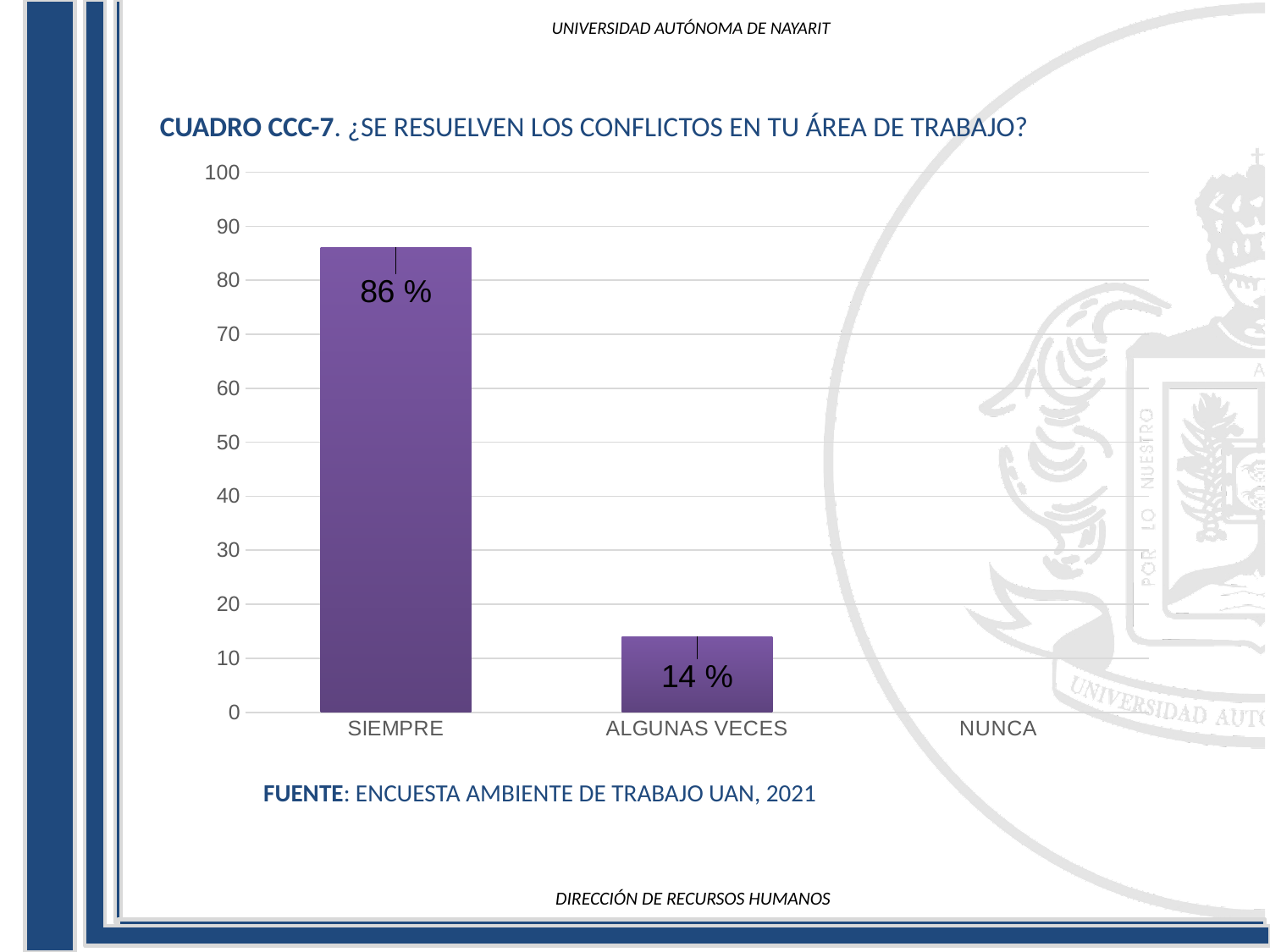
What is the title of the chart? CUADRO CCC-7. ¿SE RESUELVEN LOS CONFLICTOS EN TU ÁREA DE TRABAJO? Is the value for SIEMPRE greater or less than 80? greater Is the value for ALGUNAS VECES greater or less than 20? less What is the difference between the values for SIEMPRE and ALGUNAS VECES? 72 % What source is cited below the chart? ENCUESTA AMBIENTE DE TRABAJO UAN, 2021 What is the value for ALGUNAS VECES? 14 % How many categories are shown on the x axis? 3 Do the values rise or fall from left to right along the x axis? fall What kind of chart is shown on the slide? bar chart What is the value for SIEMPRE? 86 % Which is larger, the value for SIEMPRE or the value for ALGUNAS VECES? SIEMPRE Which category has the highest value? SIEMPRE